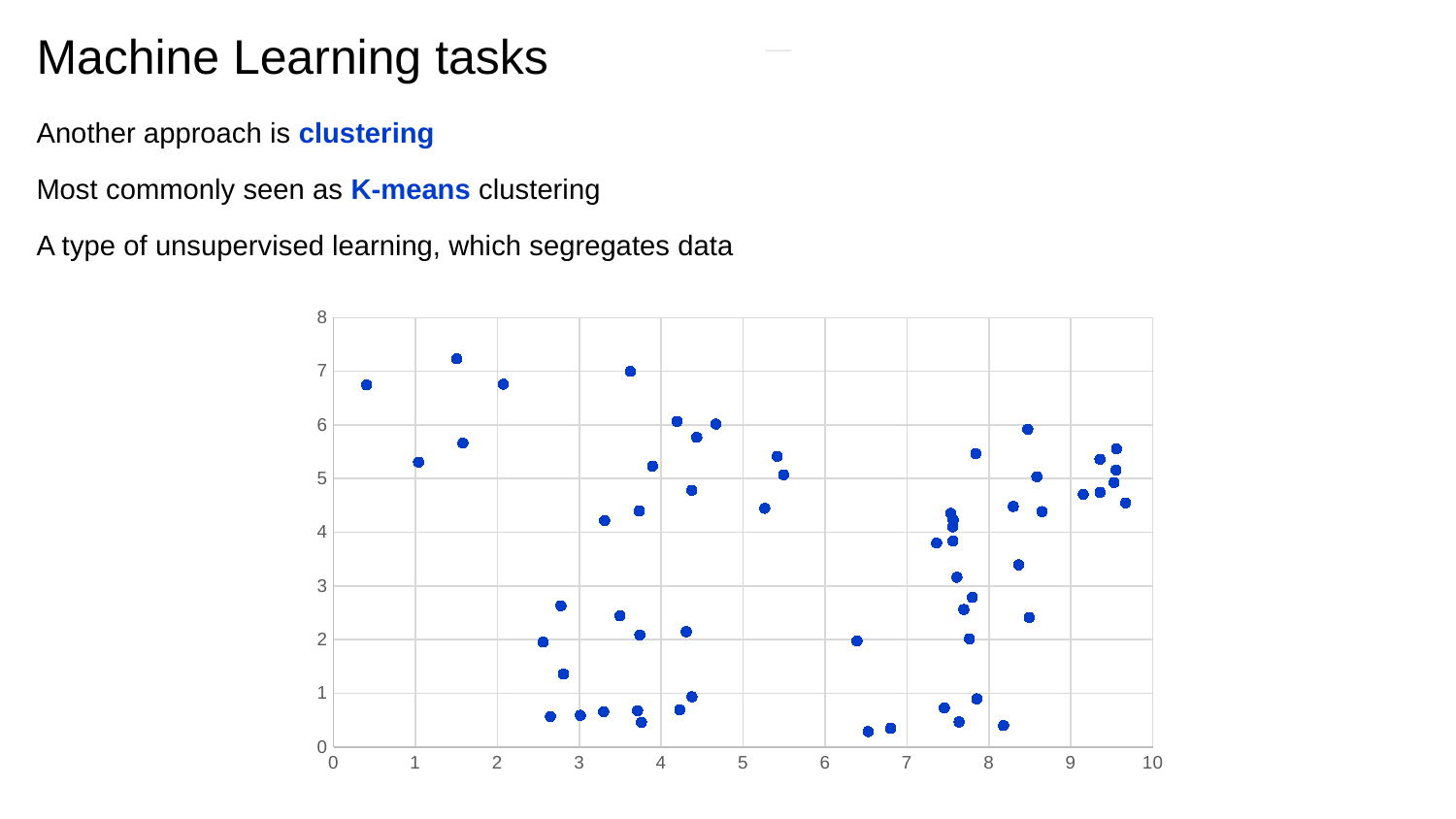
Are there any points on the chart with a y value above 8? No What kind of chart is shown on the slide? scatter chart What is the highest value shown on the y axis of the chart? 8 Is the x value of the rightmost point on the chart greater or less than 9? greater Is the y value of the lowest point on the chart greater or less than 1? less What is the highest value shown on the x axis of the chart? 10